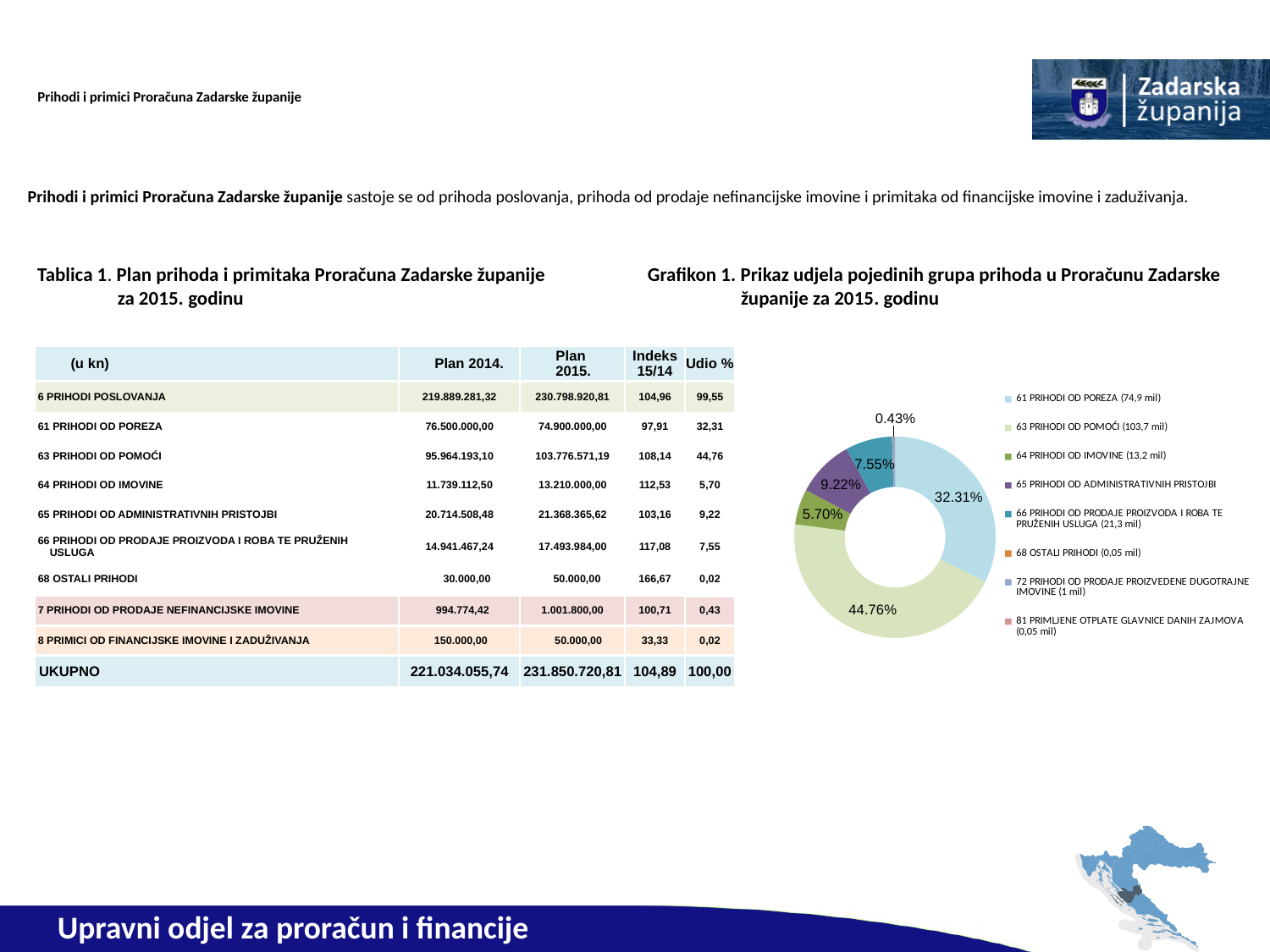
What kind of chart is Grafikon 1 on the slide? doughnut chart In Grafikon 1, how many percentage points larger is the share of 63 PRIHODI OD POMOĆI than that of 61 PRIHODI OD POREZA? 12.45 percentage points In Grafikon 1, what share is shown for 66 PRIHODI OD PRODAJE PROIZVODA I ROBA TE PRUŽENIH USLUGA? 7.55% How many entries does the legend of Grafikon 1 list? 8 In Grafikon 1, what share is shown for 64 PRIHODI OD IMOVINE? 5.70% What is the title of the chart on the right side of the slide? Grafikon 1. Prikaz udjela pojedinih grupa prihoda u Proračunu Zadarske županije za 2015. godinu In Grafikon 1, which has the larger share: 65 PRIHODI OD ADMINISTRATIVNIH PRISTOJBI or 66 PRIHODI OD PRODAJE PROIZVODA I ROBA TE PRUŽENIH USLUGA? 65 PRIHODI OD ADMINISTRATIVNIH PRISTOJBI In Grafikon 1, what share is shown for 72 PRIHODI OD PRODAJE PROIZVEDENE DUGOTRAJNE IMOVINE? 0.43% In Grafikon 1, which group has the largest share? 63 PRIHODI OD POMOĆI In Grafikon 1, what share is shown for 65 PRIHODI OD ADMINISTRATIVNIH PRISTOJBI? 9.22% In Grafikon 1, what share is shown for 63 PRIHODI OD POMOĆI? 44.76% In Grafikon 1, what share is shown for 61 PRIHODI OD POREZA? 32.31%